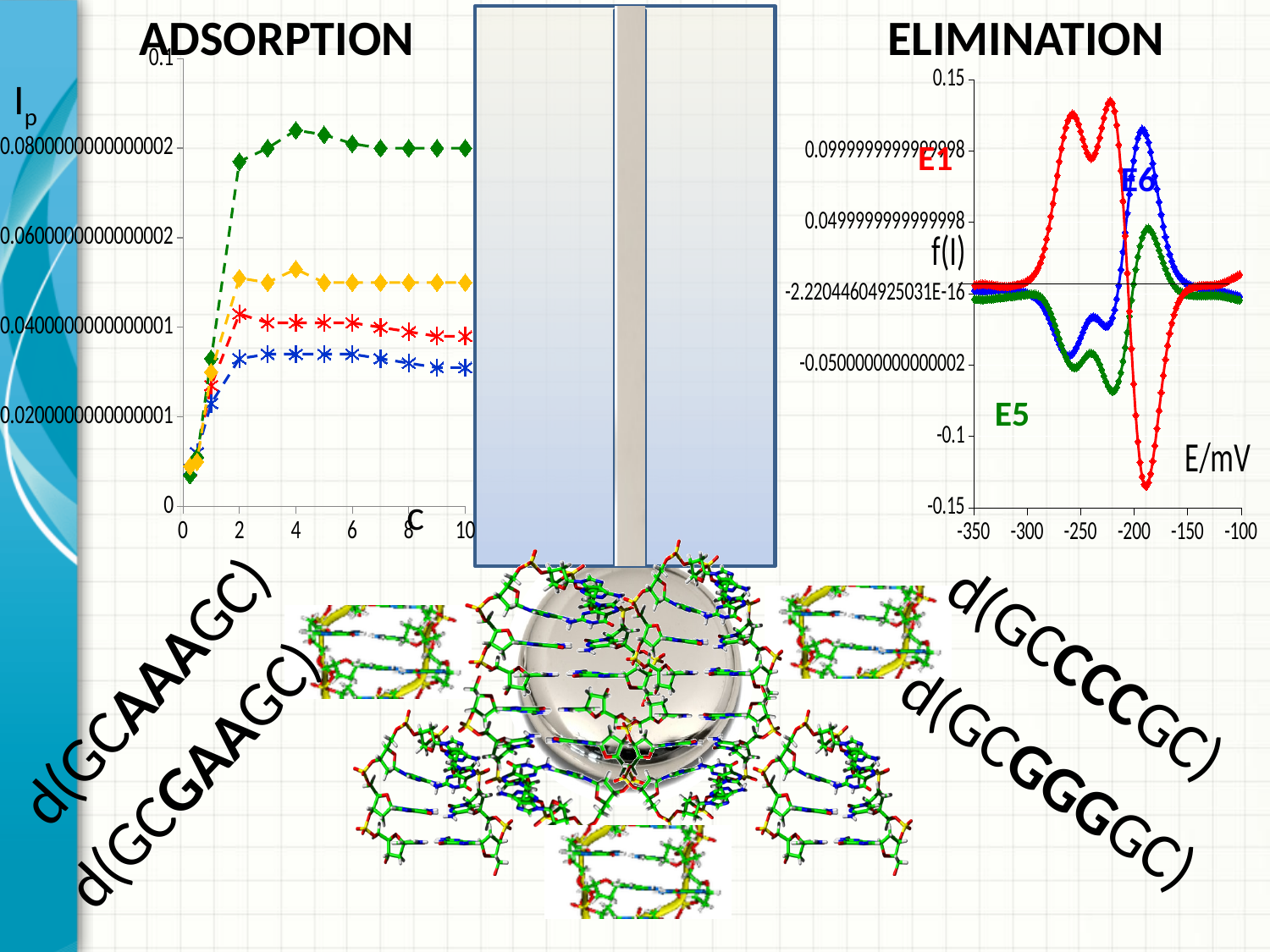
On the ELIMINATION chart, what is the label of the x axis? E/mV On the ADSORPTION chart, which series has the highest values at c = 10? the green series On the ADSORPTION chart, is the value of the blue series at c = 10 greater or less than 0.04? less On the ELIMINATION chart, how many labelled curves are plotted? 3 On the ELIMINATION chart, is the maximum of the E1 curve greater or less than 0.1? greater On the ADSORPTION chart, how many data series are plotted? 4 What kind of chart is the ADSORPTION chart on the left? line chart What kind of chart is the ELIMINATION chart on the right? line chart On the ADSORPTION chart, how do the values of each series change as c increases from 0 to 2? they rise On the ADSORPTION chart, which series has the lowest values at c = 10? the blue series On the ELIMINATION chart, is the minimum of the E1 curve greater or less than -0.1? less